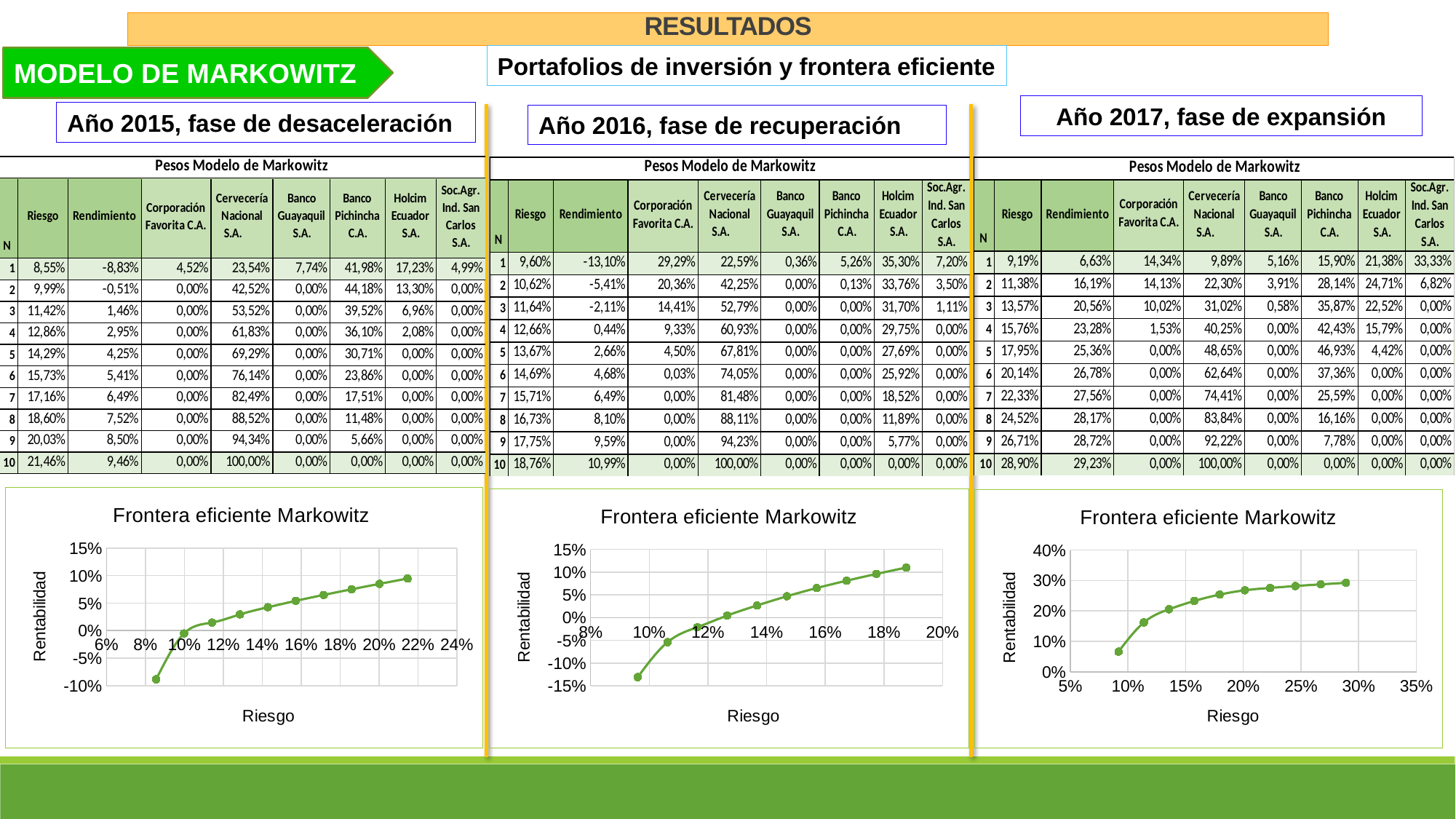
How many data points are plotted on the left chart (Año 2015) 'Frontera eficiente Markowitz'? 10 On the left chart (Año 2015), does Rentabilidad rise or fall as Riesgo increases along the x axis? rise What kind of chart is the left chart titled 'Frontera eficiente Markowitz' (Año 2015)? line chart What is the x-axis title of the middle chart (Año 2016) 'Frontera eficiente Markowitz'? Riesgo On the right chart (Año 2017), is the Rentabilidad of the highest point greater or less than 20%? greater On the left chart (Año 2015), is the Rentabilidad of the highest point greater or less than 10%? less What is the highest tick value shown on the y axis of the right chart (Año 2017)? 40% On the left chart (Año 2015), is the Rentabilidad of the lowest point greater or less than 0%? less How many data points are plotted on the middle chart (Año 2016) 'Frontera eficiente Markowitz'? 10 On the right chart (Año 2017), does Rentabilidad rise or fall as Riesgo increases along the x axis? rise